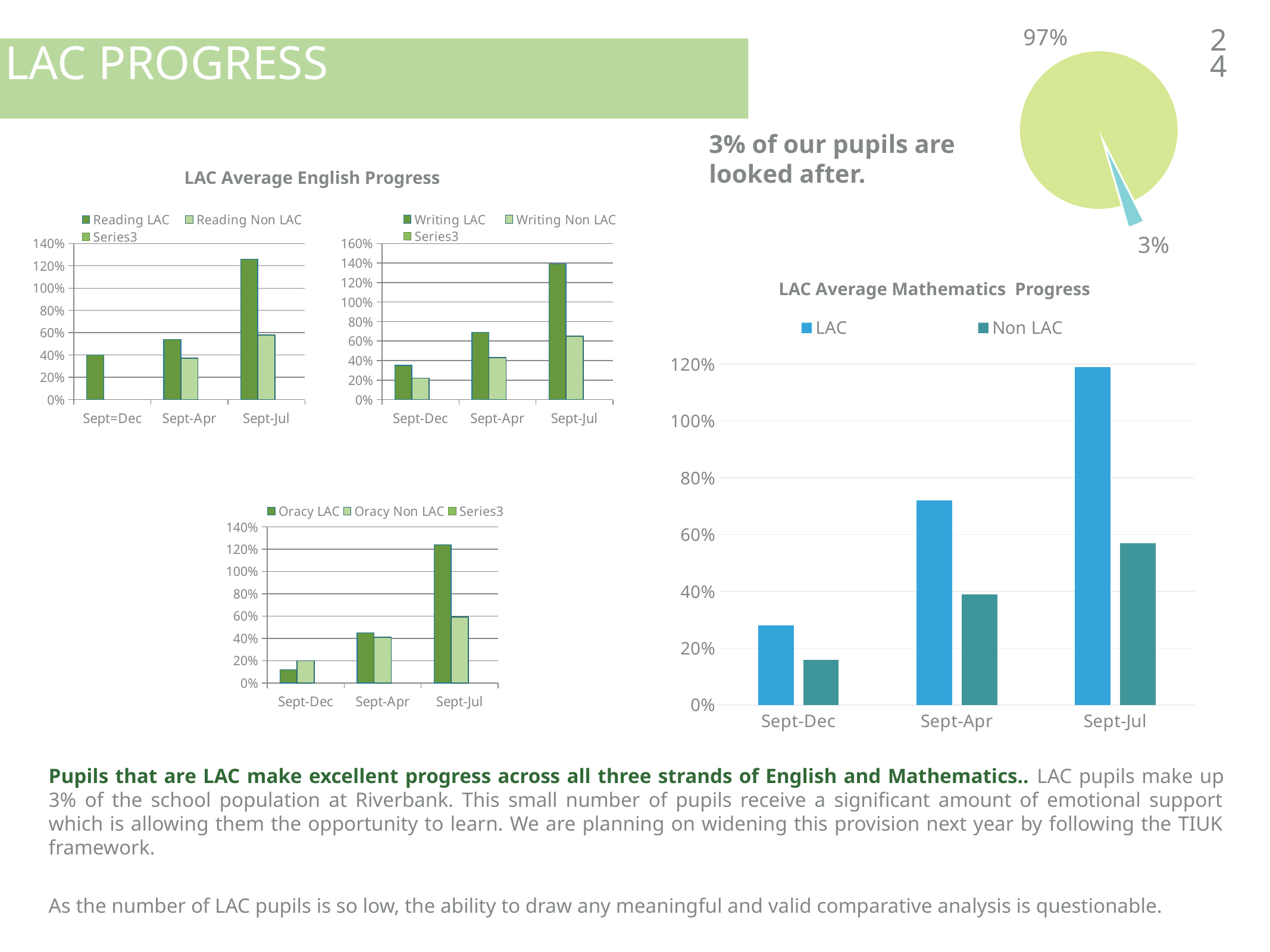
On the Writing chart, is the Writing LAC value for Sept-Apr greater or less than 60%? greater What kind of chart is the LAC Average Mathematics Progress chart? bar chart On the pie chart at the top right, what percentage is shown for the larger slice? 97% On the pie chart at the top right, what share of pupils are looked after? 3% On the Oracy chart, which is larger for Sept-Dec: Oracy LAC or Oracy Non LAC? Oracy Non LAC How many categories are on the x axis of the LAC Average Mathematics Progress chart? 3 On the LAC Average Mathematics Progress chart, do the LAC values rise or fall from Sept-Dec to Sept-Jul? rise On the LAC Average Mathematics Progress chart, is the LAC value for Sept-Jul greater or less than 100%? greater How many series does the legend of the LAC Average Mathematics Progress chart list? 2 On the LAC Average Mathematics Progress chart, is the Non LAC value for Sept-Dec greater or less than 20%? less On the LAC Average Mathematics Progress chart, which category has the highest LAC value? Sept-Jul